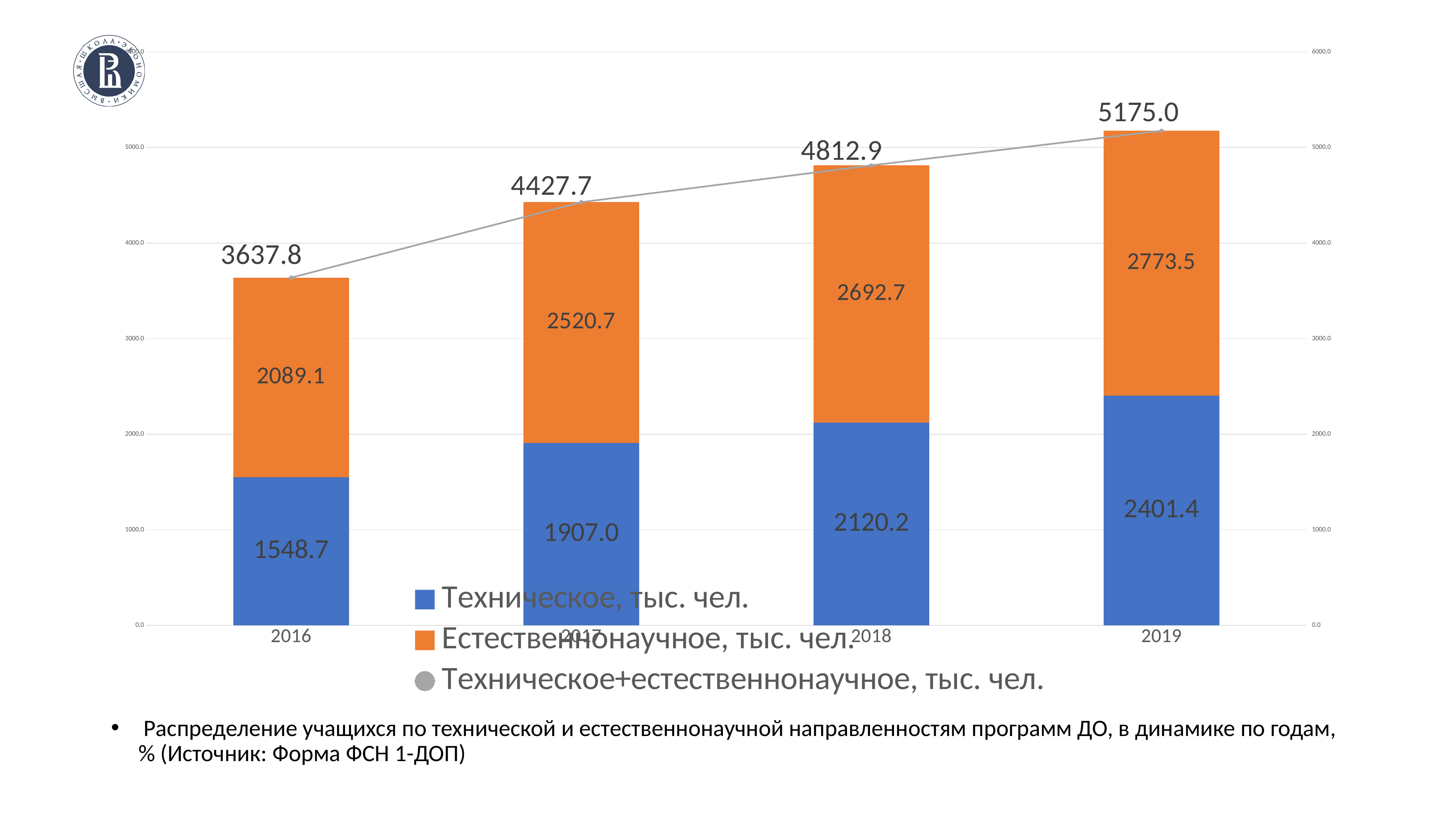
What is the value of Техническое+естественнонаучное, тыс. чел. for 2018? 4812.9 Which is larger: Естественнонаучное, тыс. чел. in 2017 or Техническое, тыс. чел. in 2018? Естественнонаучное, тыс. чел. in 2017 What is the value of Естественнонаучное, тыс. чел. for 2019? 2773.5 Which year has the highest value for Техническое+естественнонаучное, тыс. чел.? 2019 Which year has the lowest value for Естественнонаучное, тыс. чел.? 2016 How many series does the legend list? 3 What kind of chart is shown on the slide? Stacked bar chart with a line Does the value for Техническое, тыс. чел. rise or fall from 2016 to 2019? rise How many years are shown on the x axis? 4 What is the value of Техническое, тыс. чел. for 2016? 1548.7 Is the value for Техническое+естественнонаучное, тыс. чел. in 2017 greater or less than 4000.0? greater What is the difference between the Техническое, тыс. чел. values for 2019 and 2016? 852.7